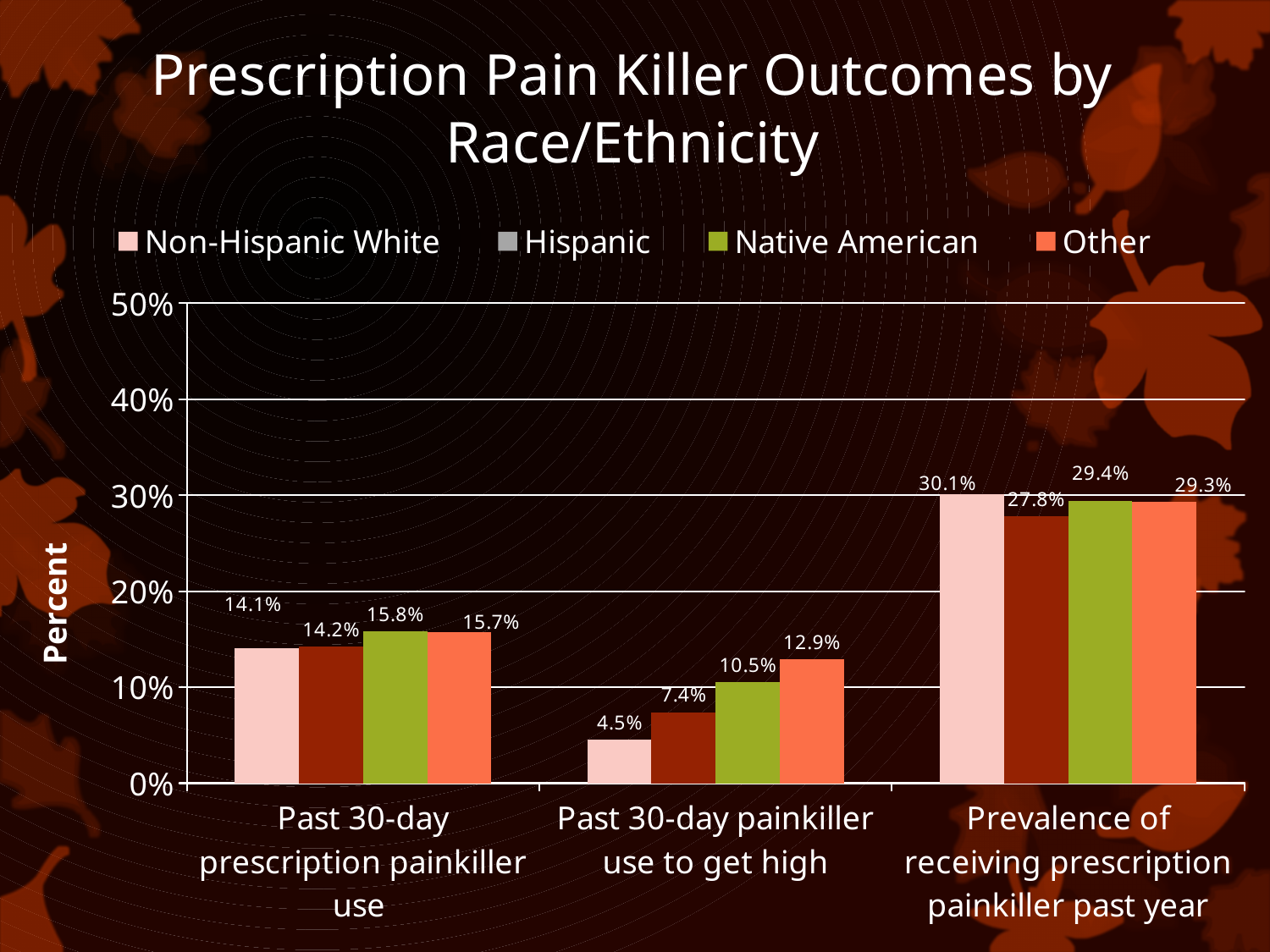
What kind of chart is shown on the slide? bar chart In the "Prevalence of receiving prescription painkiller past year" category, which is larger: Non-Hispanic White or Hispanic? Non-Hispanic White What is the value for Non-Hispanic White in the "Past 30-day painkiller use to get high" category? 4.5% Which group has the highest value in the "Past 30-day painkiller use to get high" category? Other Which group has the lowest value in the "Prevalence of receiving prescription painkiller past year" category? Hispanic What is the value for Other in the "Past 30-day painkiller use to get high" category? 12.9% How many series does the legend list? 4 What is the difference between the Other and Non-Hispanic White values in the "Past 30-day painkiller use to get high" category? 8.4% What is the value for Native American in the "Past 30-day prescription painkiller use" category? 15.8% Is the Native American value in the "Past 30-day painkiller use to get high" category greater or less than 20%? less How many categories are shown on the x axis? 3 What is the value for Hispanic in the "Prevalence of receiving prescription painkiller past year" category? 27.8%